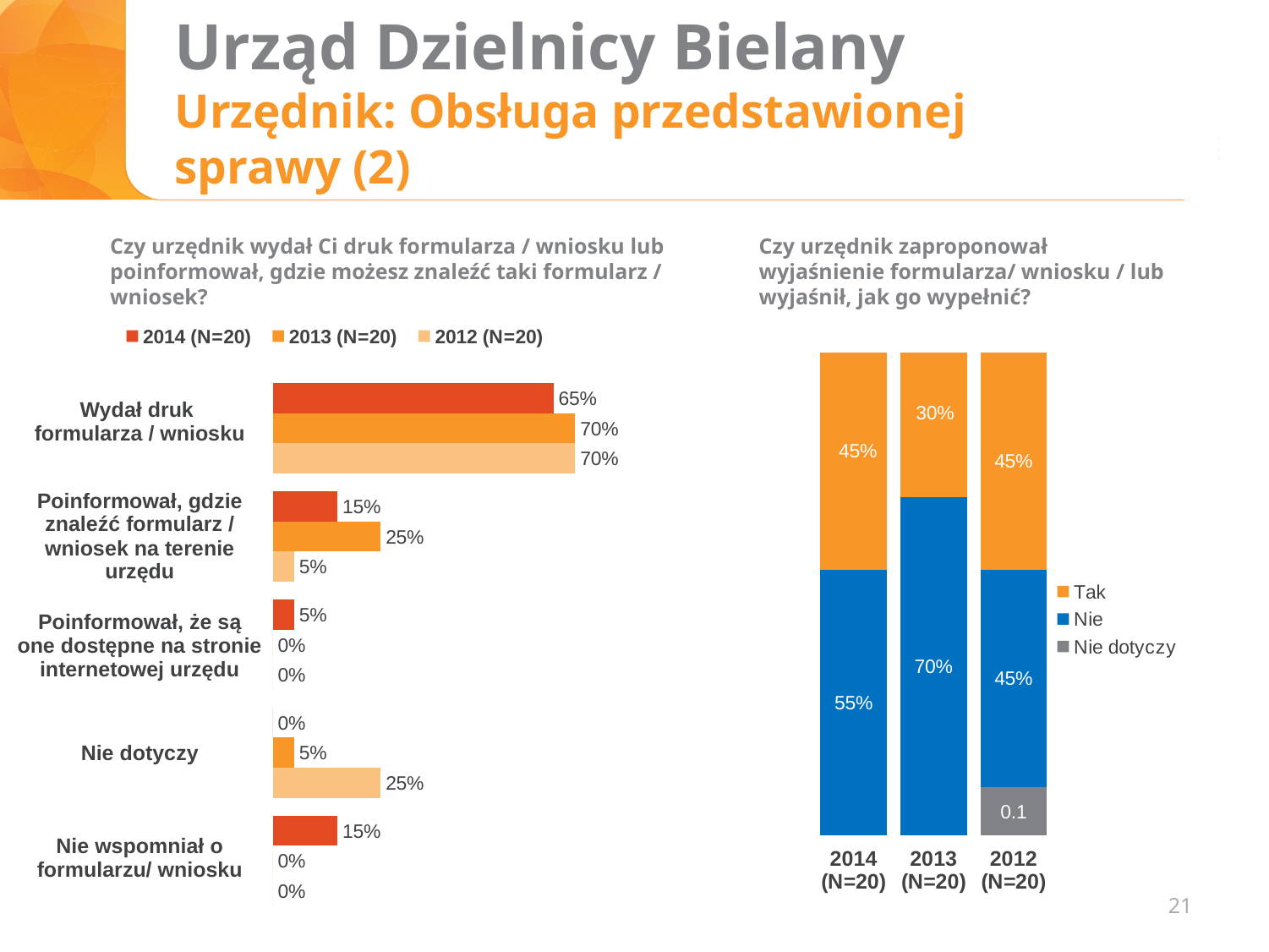
In the left chart, what is the 2012 (N=20) value for "Nie dotyczy"? 25% In the left chart, what is the 2013 (N=20) value for "Poinformował, gdzie znaleźć formularz / wniosek na terenie urzędu"? 25% In the right chart, how many series does the legend list? 3 In the left chart, what is the difference between the 2013 and 2014 values for "Wydał druk formularza / wniosku"? 5% In the right chart, which year has the lowest "Tak" value? 2013 (N=20) In the right chart, what is the "Tak" value for 2014 (N=20)? 45% In the right chart, what is the "Nie" value for 2013 (N=20)? 70% In the left chart, how many series does the legend list? 3 In the left chart, what is the 2014 (N=20) value for "Wydał druk formularza / wniosku"? 65% In the left chart, which category has the highest 2014 (N=20) value? Wydał druk formularza / wniosku What kind of chart is the left chart? Bar chart In the left chart, how many categories are shown? 5